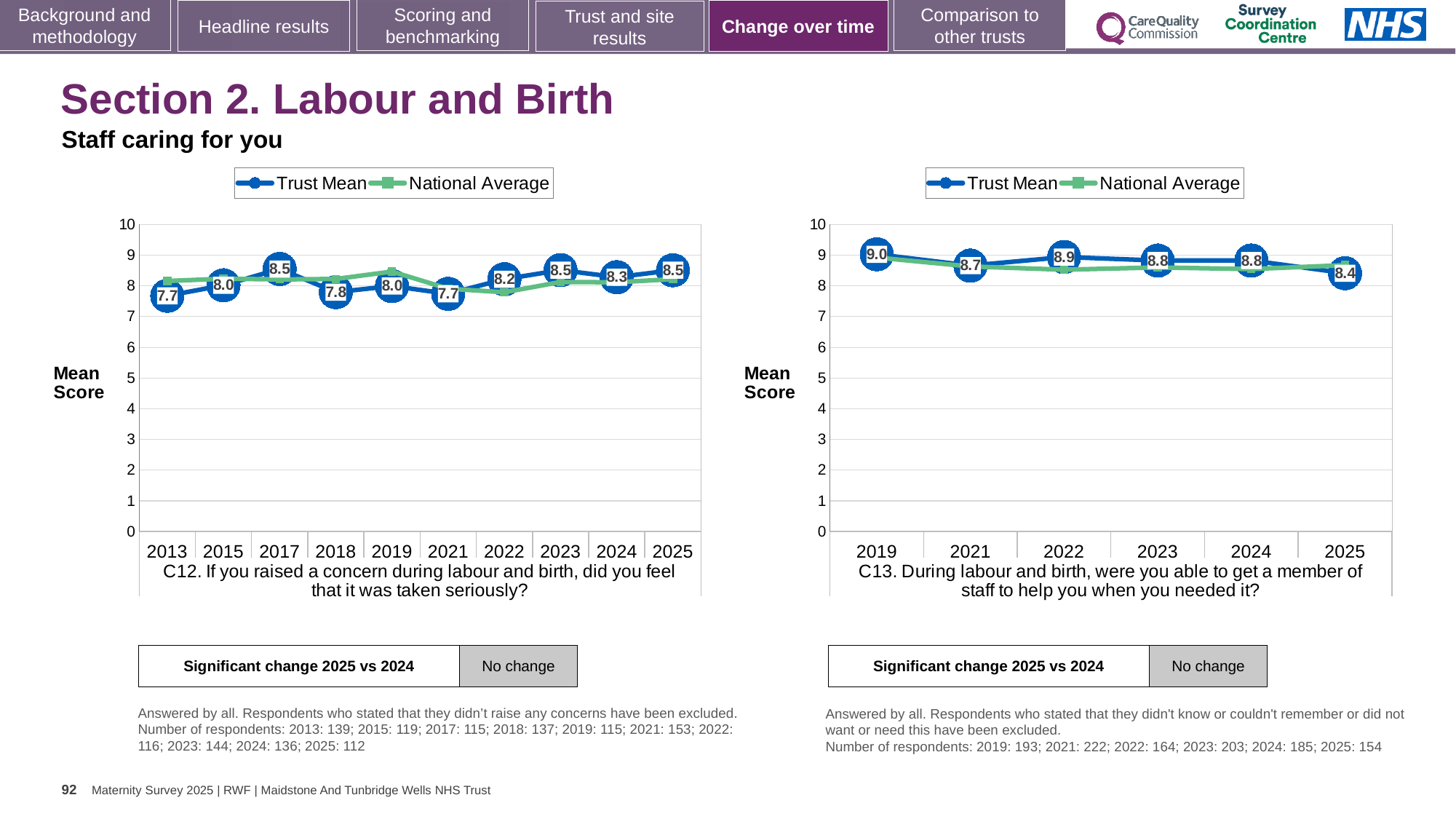
In the C12 chart (left), what is the Trust Mean for 2013? 7.7 In the C13 chart (right), which year has the highest Trust Mean? 2019 In the C12 chart (left), which is larger: the Trust Mean for 2017 or the Trust Mean for 2018? 2017 In the C13 chart (right), what is the Trust Mean for 2025? 8.4 In the C13 chart (right), what is the Trust Mean for 2019? 9.0 In the C13 chart (right), what is the difference between the Trust Mean for 2019 and the Trust Mean for 2025? 0.6 How many series does the legend of the C13 chart (right) list? 2 What kind of chart is the C13 chart (right)? Line chart How many years are plotted on the x axis of the C12 chart (left)? 10 In the C12 chart (left), what is the difference between the Trust Mean for 2025 and the Trust Mean for 2013? 0.8 In the C12 chart (left), what is the Trust Mean for 2025? 8.5 In the C13 chart (right), which year has the lowest Trust Mean? 2025